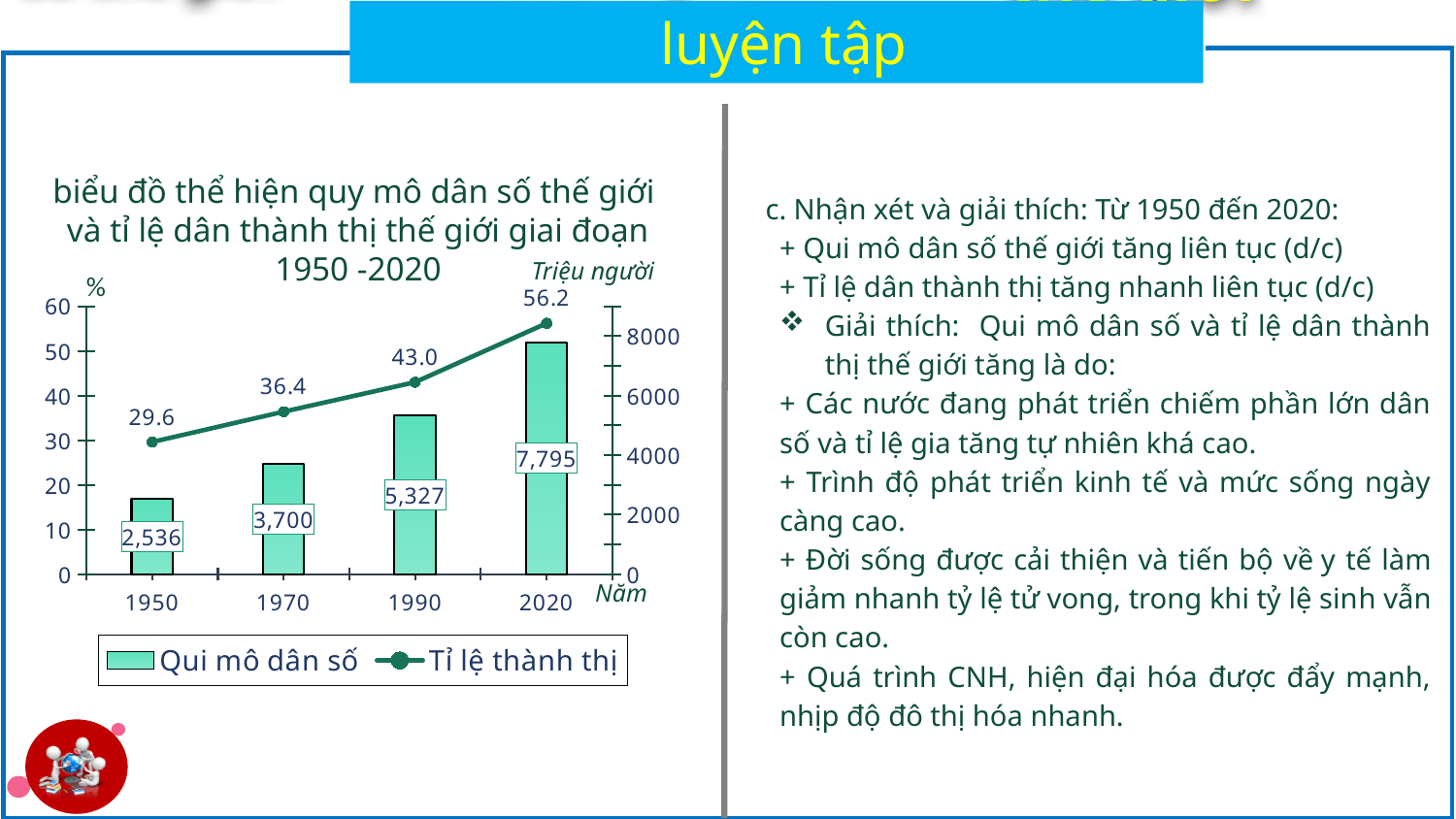
What is the difference between Tỉ lệ thành thị in 1990 and in 1970? 6.6 In which year is Qui mô dân số highest? 2020 In which year is Tỉ lệ thành thị lowest? 1950 What is the value of Qui mô dân số in 1950? 2,536 Which is larger, Qui mô dân số in 1970 or in 1990? 1990 What is the difference between Qui mô dân số in 2020 and in 1950? 5,259 What is the value of Qui mô dân số in 1990? 5,327 Does Tỉ lệ thành thị rise or fall from 1950 to 2020? rise What is the value of Tỉ lệ thành thị in 2020? 56.2 What is the value of Tỉ lệ thành thị in 1970? 36.4 How many years are shown on the x axis? 4 How many series does the legend list? 2